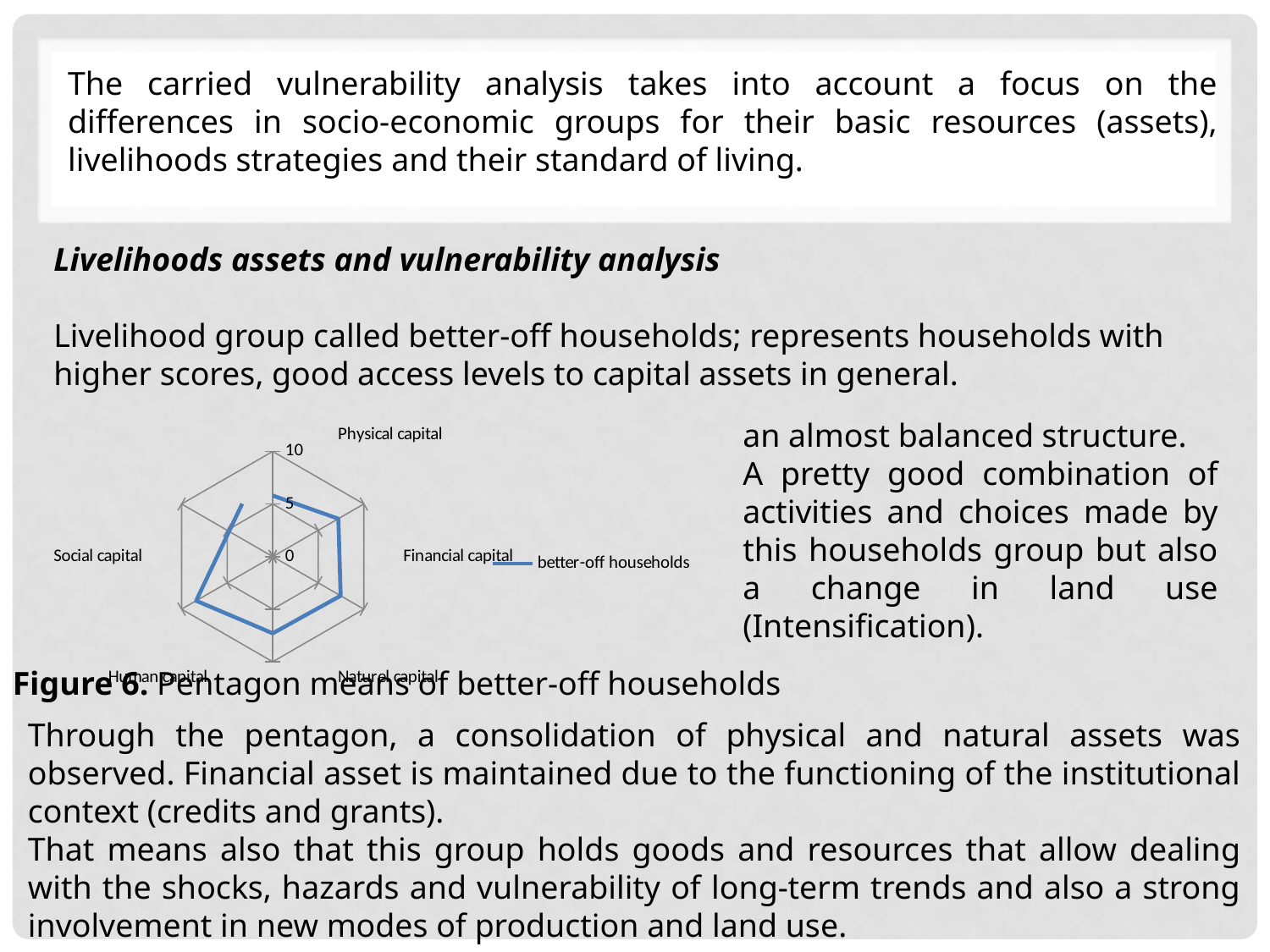
What is the name of the series shown in the chart legend? better-off households Is the value for Natural capital greater or less than 5? greater What kind of chart is shown on the slide? Radar chart What is the maximum value shown on the radar chart's axis scale? 10 How many series does the chart legend list? 1 Is the value for Human capital greater or less than 5? greater Is the value for Financial capital greater or less than 5? greater Which is larger, the value for Human capital or the value for Physical capital? Human capital How many capital categories are labelled on the radar chart? 5